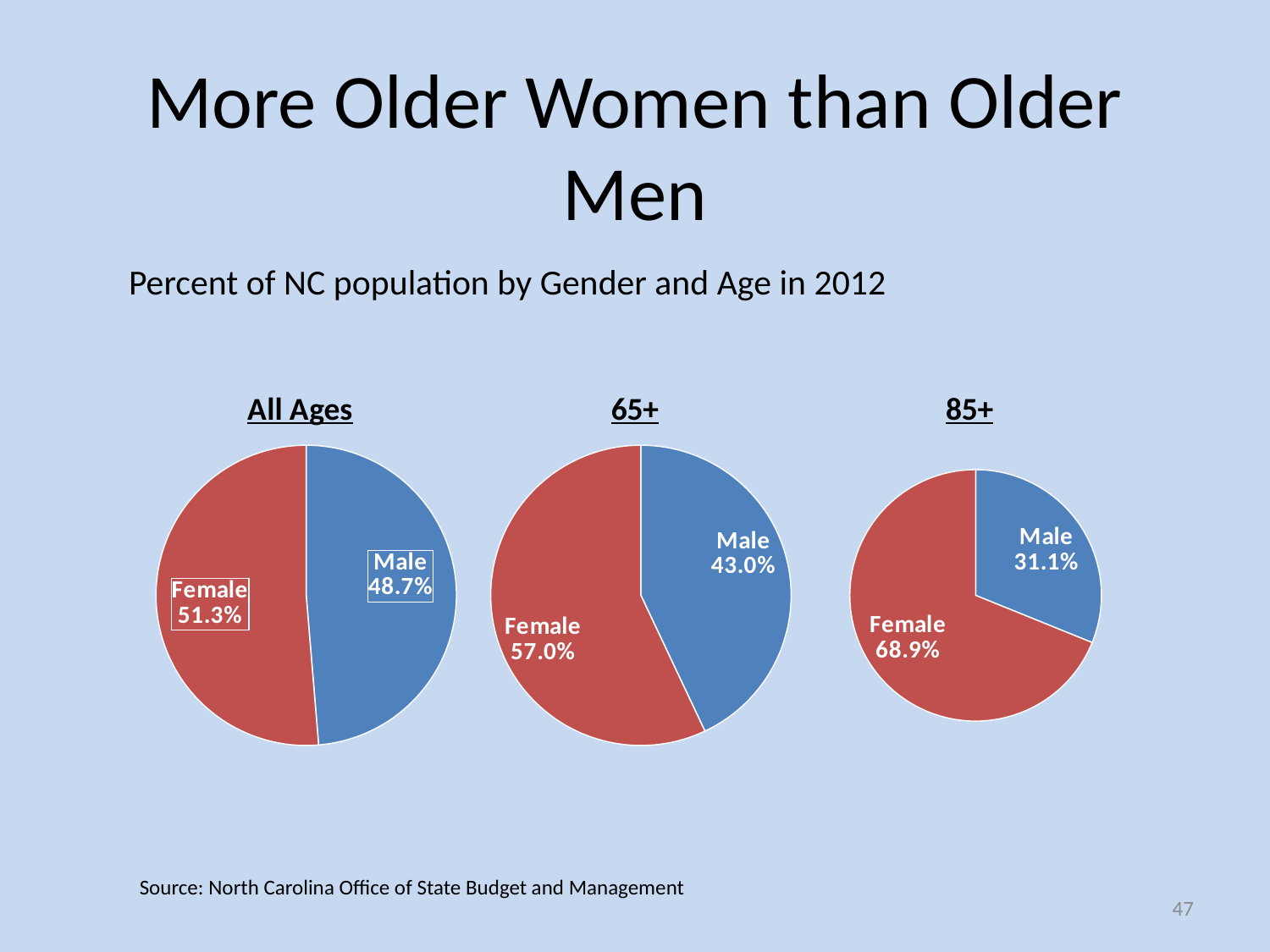
In the 'All Ages' pie chart, what is the value for Female? 51.3% In the '65+' pie chart, what is the difference between the Female and Male values? 14.0% In the '65+' pie chart, what is the value for Male? 43.0% In the '85+' pie chart, what is the value for Female? 68.9% In the '85+' pie chart, which slice is the smallest? Male In the '85+' pie chart, what is the difference between the Female and Male values? 37.8% In the 'All Ages' pie chart, what is the difference between the Female and Male values? 2.6% What kind of chart is the 'All Ages' chart? Pie chart How many slices does the '65+' pie chart have? 2 In the '65+' pie chart, which slice is larger, Female or Male? Female In the '85+' pie chart, what is the value for Male? 31.1% How many pie charts are shown on the slide? 3